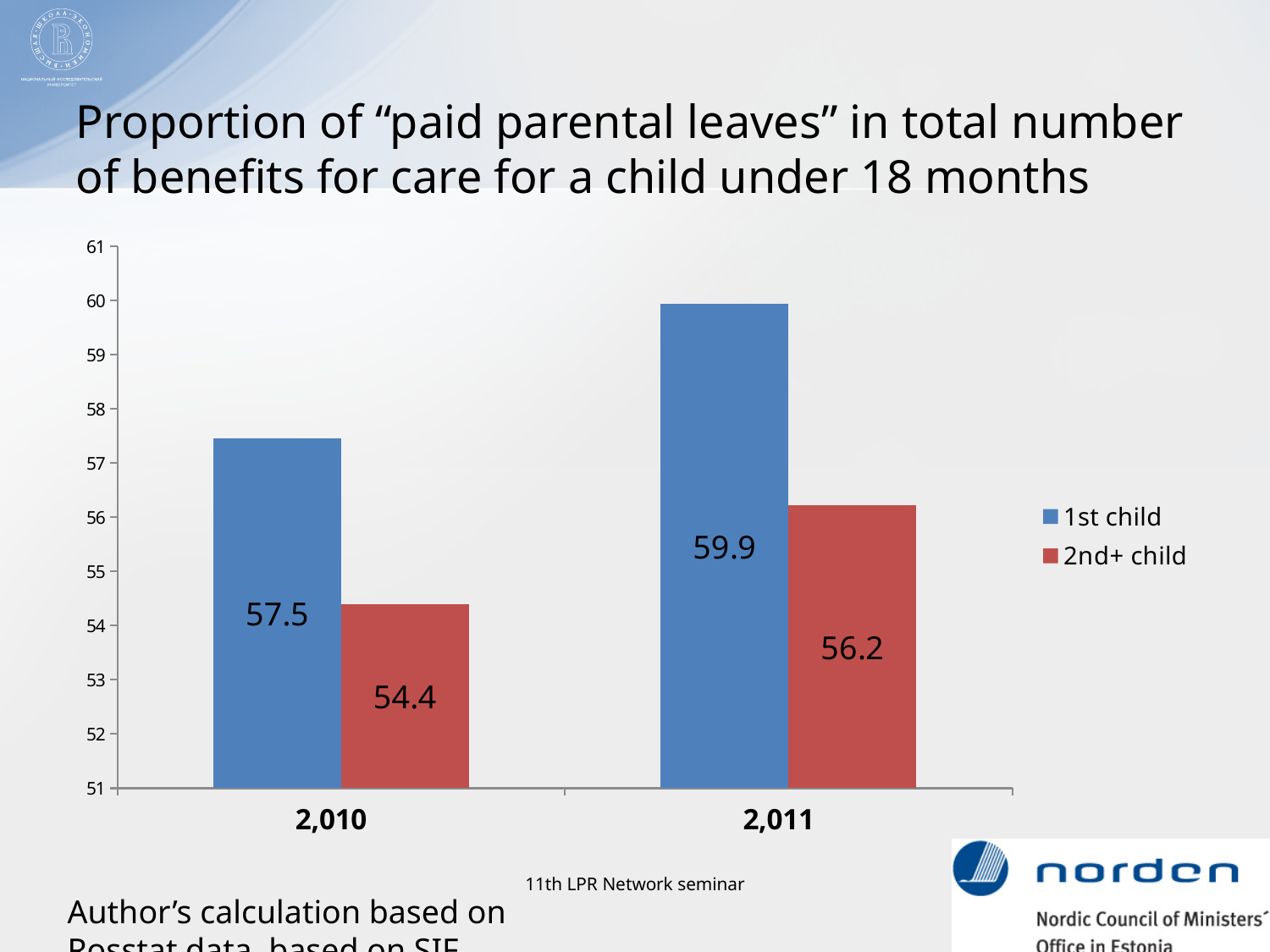
Which bar has the lowest value on the chart? 2nd+ child in 2,010 Which is larger, the 2nd+ child value in 2,010 or in 2,011? 2,011 Is the value for 1st child in 2,011 greater or less than 59? greater By how much did the 1st child value increase from 2,010 to 2,011? 2.4 How many series does the legend list? 2 Which bar has the highest value on the chart? 1st child in 2,011 What is the value for 1st child in 2,010? 57.5 What kind of chart is shown on the slide? Bar chart Do the values for 2nd+ child rise or fall from 2,010 to 2,011? Rise What is the value for 2nd+ child in 2,010? 54.4 What is the value for 2nd+ child in 2,011? 56.2 What is the difference between the 1st child and 2nd+ child values in 2,011? 3.7